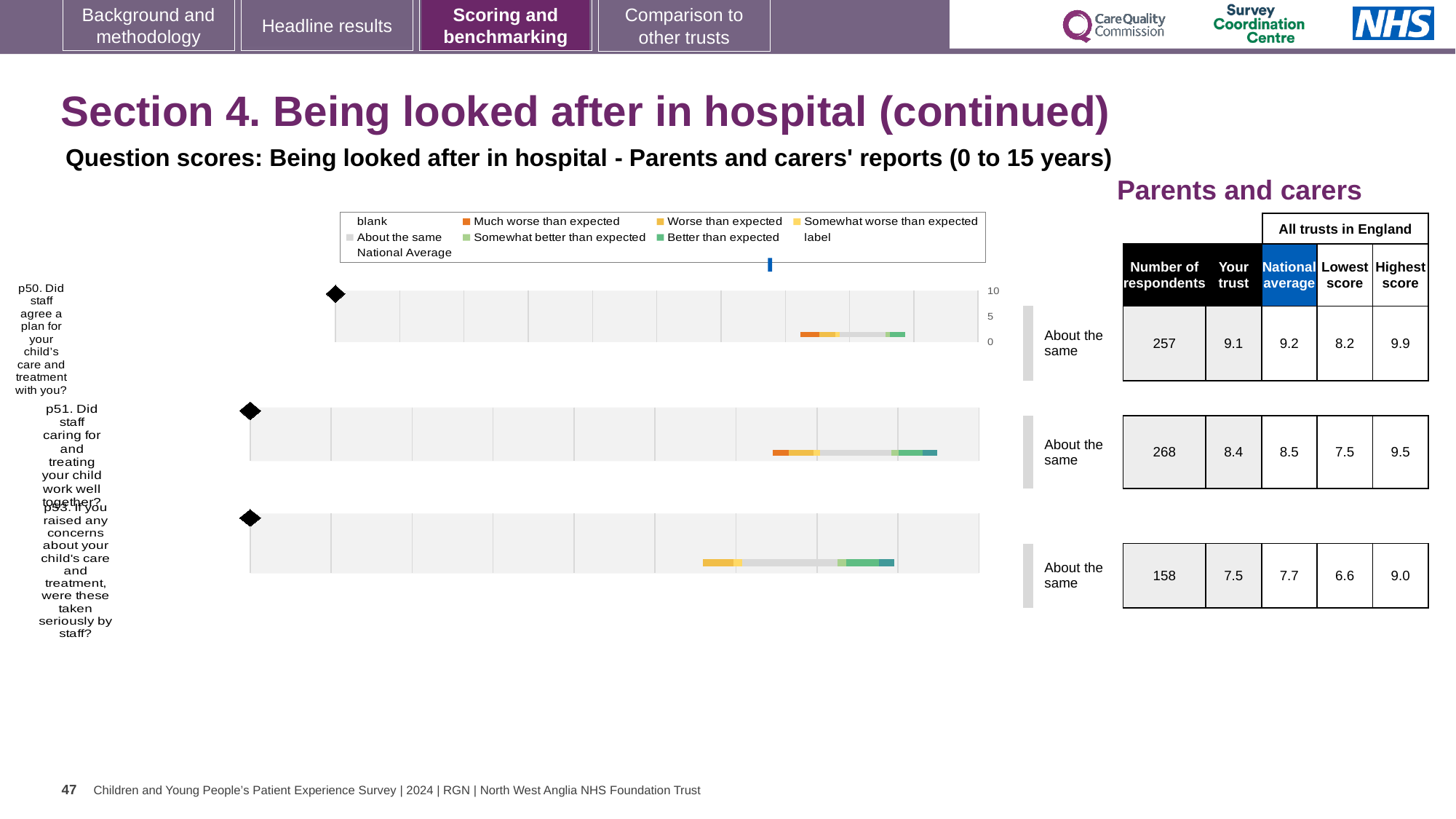
How many respondents answered p53 (If you raised any concerns about your child's care and treatment, were these taken seriously by staff?)? 158 What is the highest score among all trusts in England for p50? 9.9 What benchmark category is shown for p50? About the same How many survey questions are plotted on the slide? 3 What is the lowest score among all trusts in England for p53? 6.6 What is the 'Your trust' score for p50 (Did staff agree a plan for your child's care and treatment with you?)? 9.1 What kind of chart is used to show the question scores on this slide? bar chart Which question has the lowest number of respondents? p53 For p51, which is larger: the 'Your trust' score or the national average? National average What is the national average score for p51 (Did staff caring for and treating your child work well together?)? 8.5 What is the difference between the highest score and the lowest score for p53? 2.4 Which question has the highest 'Your trust' score? p50